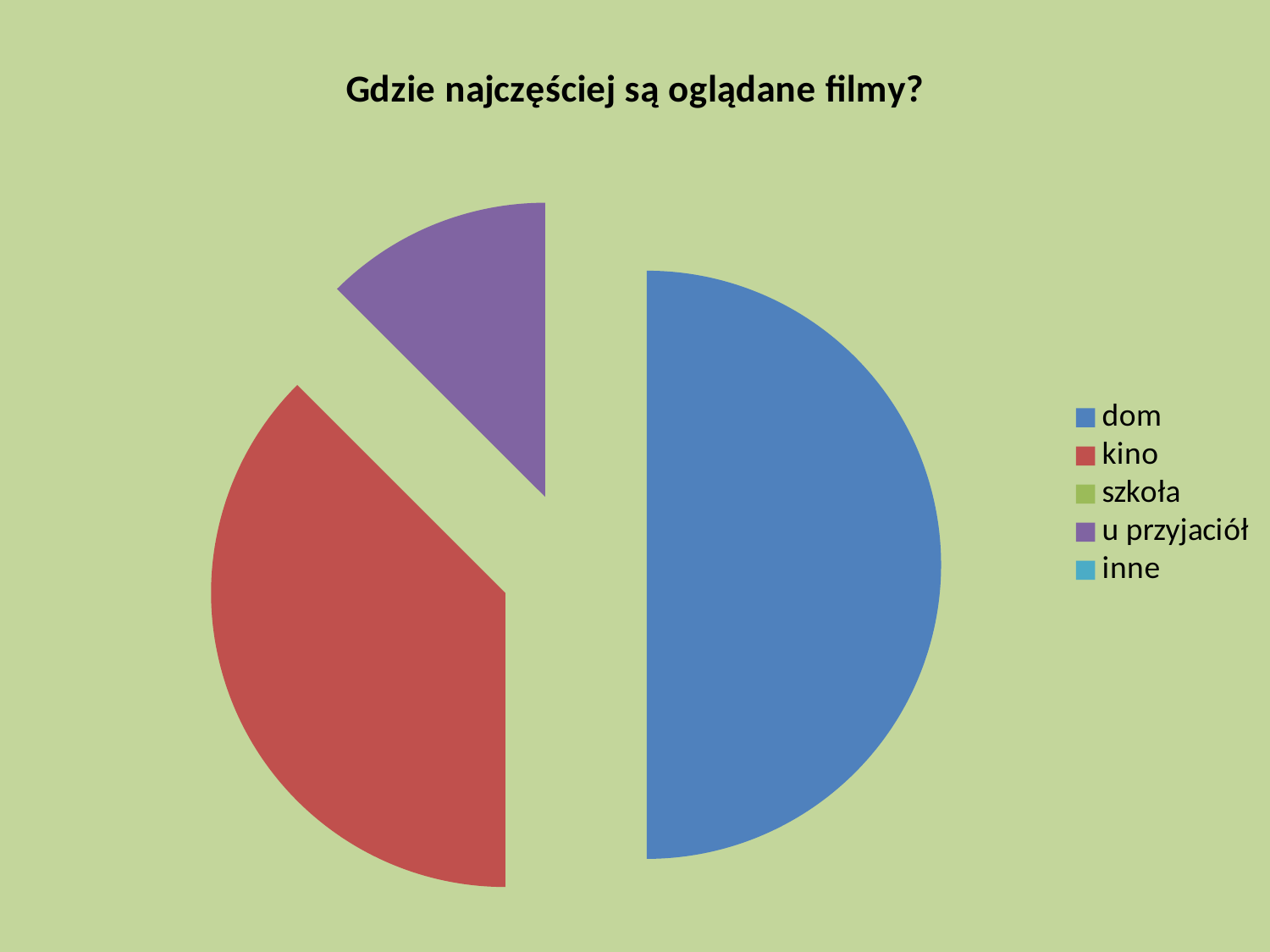
Which of the visible slices is the smallest? u przyjaciół Which legend entries have no visible slice in the pie? szkoła and inne What kind of chart is shown on the slide? pie chart Which slice is larger, dom or kino? dom How many entries does the chart's legend list? 5 Which colour represents the category kino in the chart? red How many slices are visible in the pie chart? 3 Which category has the largest slice of the pie? dom What is the title of the chart? Gdzie najczęściej są oglądane filmy? Which slice is larger, kino or u przyjaciół? kino